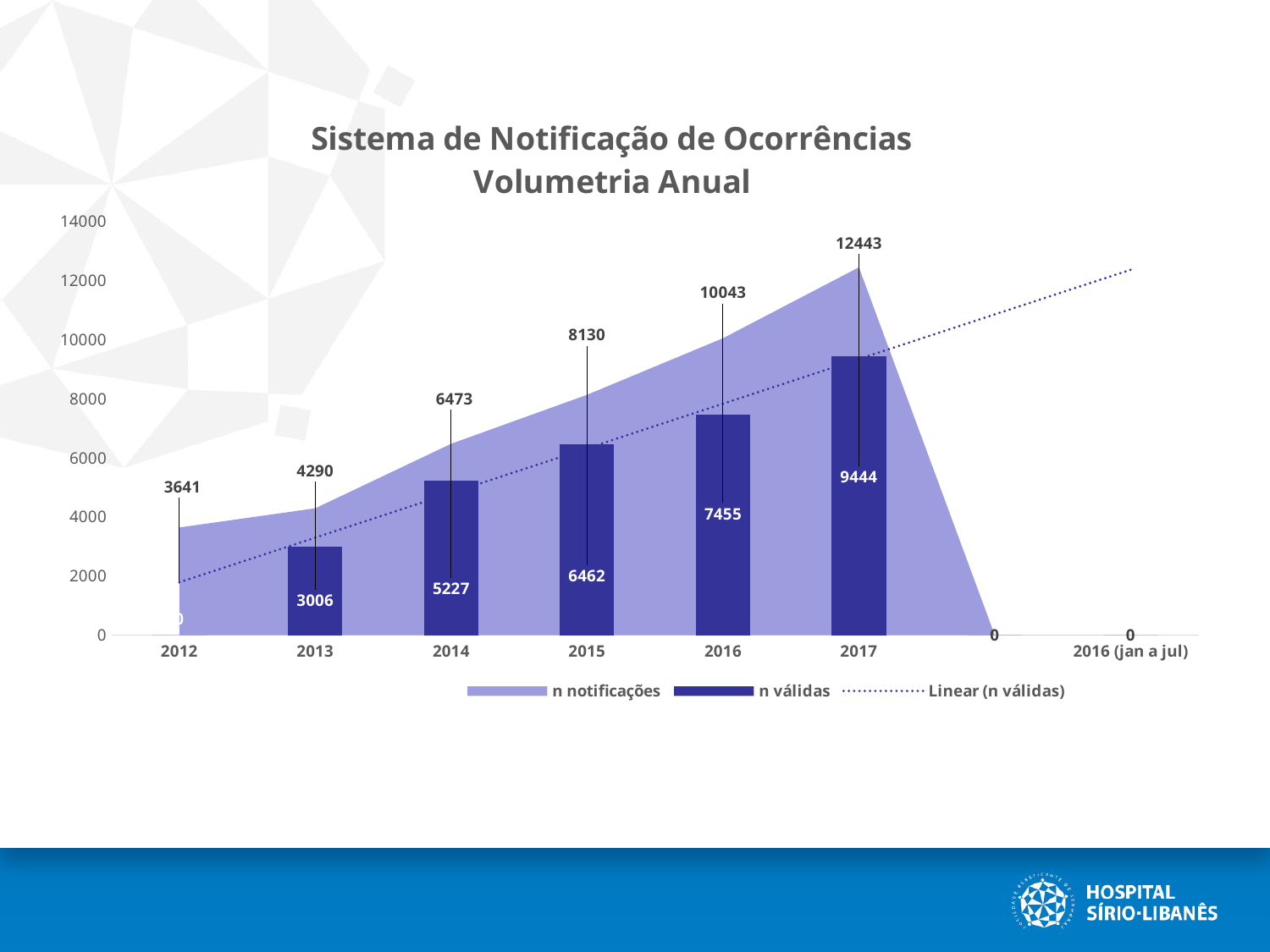
Which year has the highest value of n notificações? 2017 What is the difference between n válidas in 2014 and in 2013? 2221 Which is larger, n válidas in 2016 or n notificações in 2015? n notificações in 2015 What is the difference between n notificações and n válidas in 2017? 2999 Do the n notificações values rise or fall from 2012 to 2017? rise What is the value of n notificações for 2017? 12443 What is the title of the chart? Sistema de Notificação de Ocorrências Volumetria Anual What is the value of n notificações for 2012? 3641 What is the value of n válidas for 2015? 6462 How many series does the legend list? 3 What is the value of n válidas for 2016? 7455